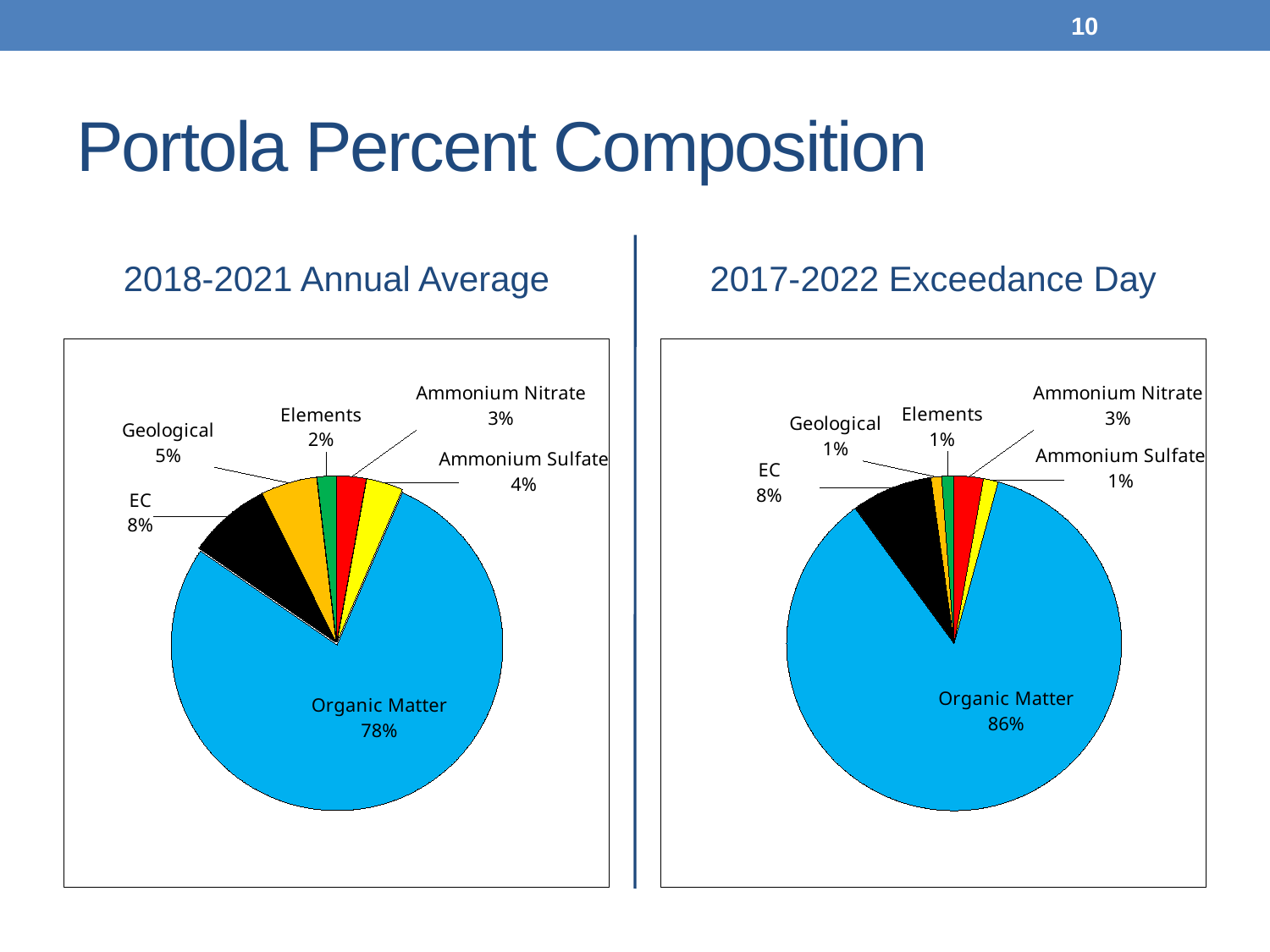
What is the title of the slide containing the two pie charts? Portola Percent Composition What is the difference between the Organic Matter share in the 2017-2022 Exceedance Day chart and the 2018-2021 Annual Average chart? 8% In the 2018-2021 Annual Average pie chart, what is the value for EC? 8% How many categories are shown in the 2017-2022 Exceedance Day pie chart? 6 In the 2018-2021 Annual Average pie chart, what is the value for Ammonium Sulfate? 4% In the 2017-2022 Exceedance Day pie chart, what share does Organic Matter have? 86% In the 2018-2021 Annual Average pie chart, what share does Organic Matter have? 78% In the 2018-2021 Annual Average pie chart, which is larger, Geological or Ammonium Nitrate? Geological What type of chart is used for the 2018-2021 Annual Average? Pie chart In the 2017-2022 Exceedance Day pie chart, which category has the largest share? Organic Matter In the 2018-2021 Annual Average pie chart, which category has the smallest share? Elements In the 2017-2022 Exceedance Day pie chart, what is the value for Geological? 1%